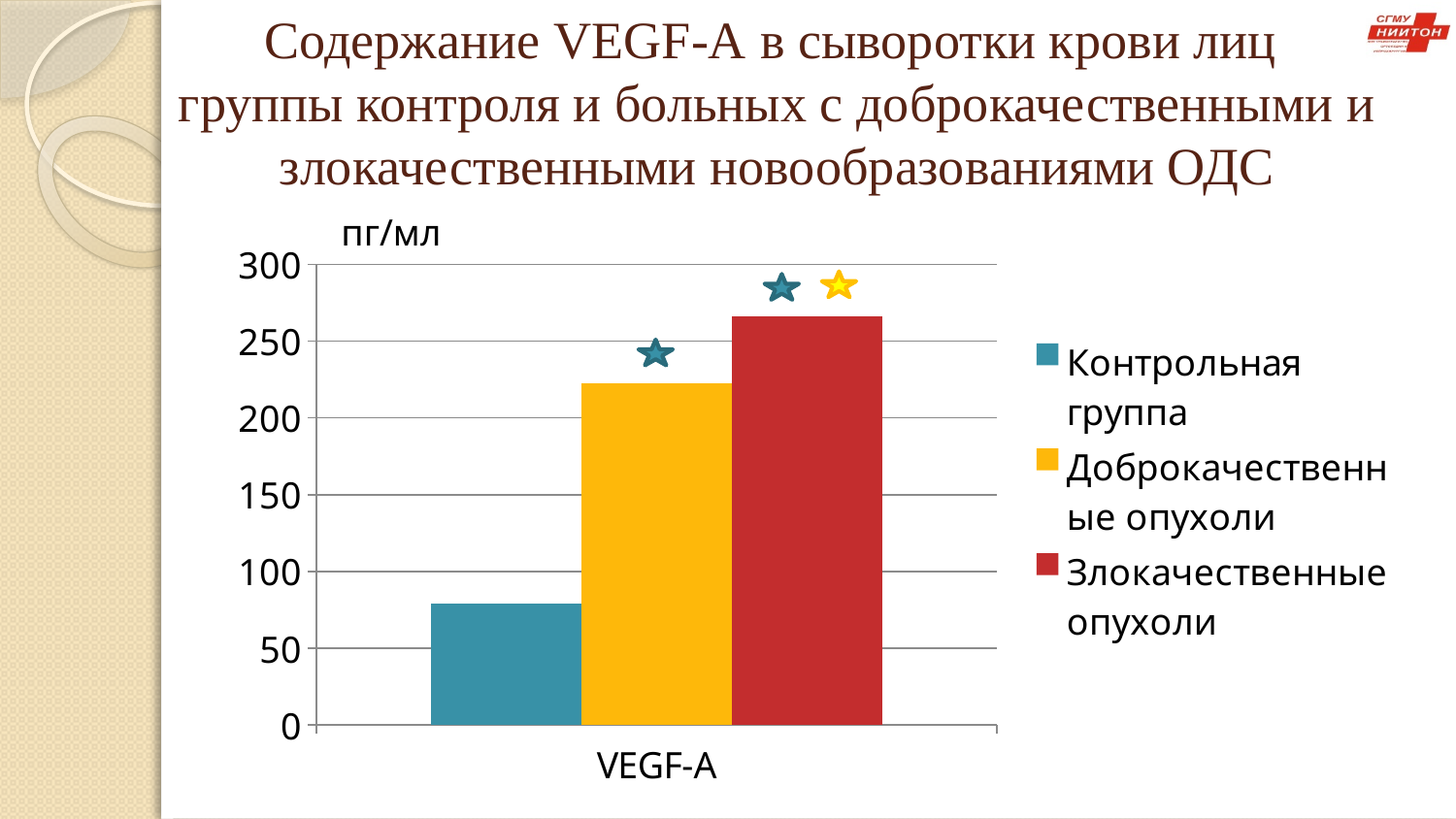
What colour is the bar for Контрольная группа? blue How many categories are shown on the x axis? 1 What unit is shown above the y axis of the chart? пг/мл Is the value for Контрольная группа greater or less than 100? less Which is larger for VEGF-A: Доброкачественные опухоли or Злокачественные опухоли? Злокачественные опухоли Is the value for Злокачественные опухоли greater or less than 250? greater How many series does the legend list? 3 What kind of chart is shown on the slide? bar chart Which is larger for VEGF-A: Контрольная группа or Доброкачественные опухоли? Доброкачественные опухоли Is the value for Доброкачественные опухоли greater or less than 200? greater Which series has the lowest value for VEGF-A? Контрольная группа Which series has the highest value for VEGF-A? Злокачественные опухоли